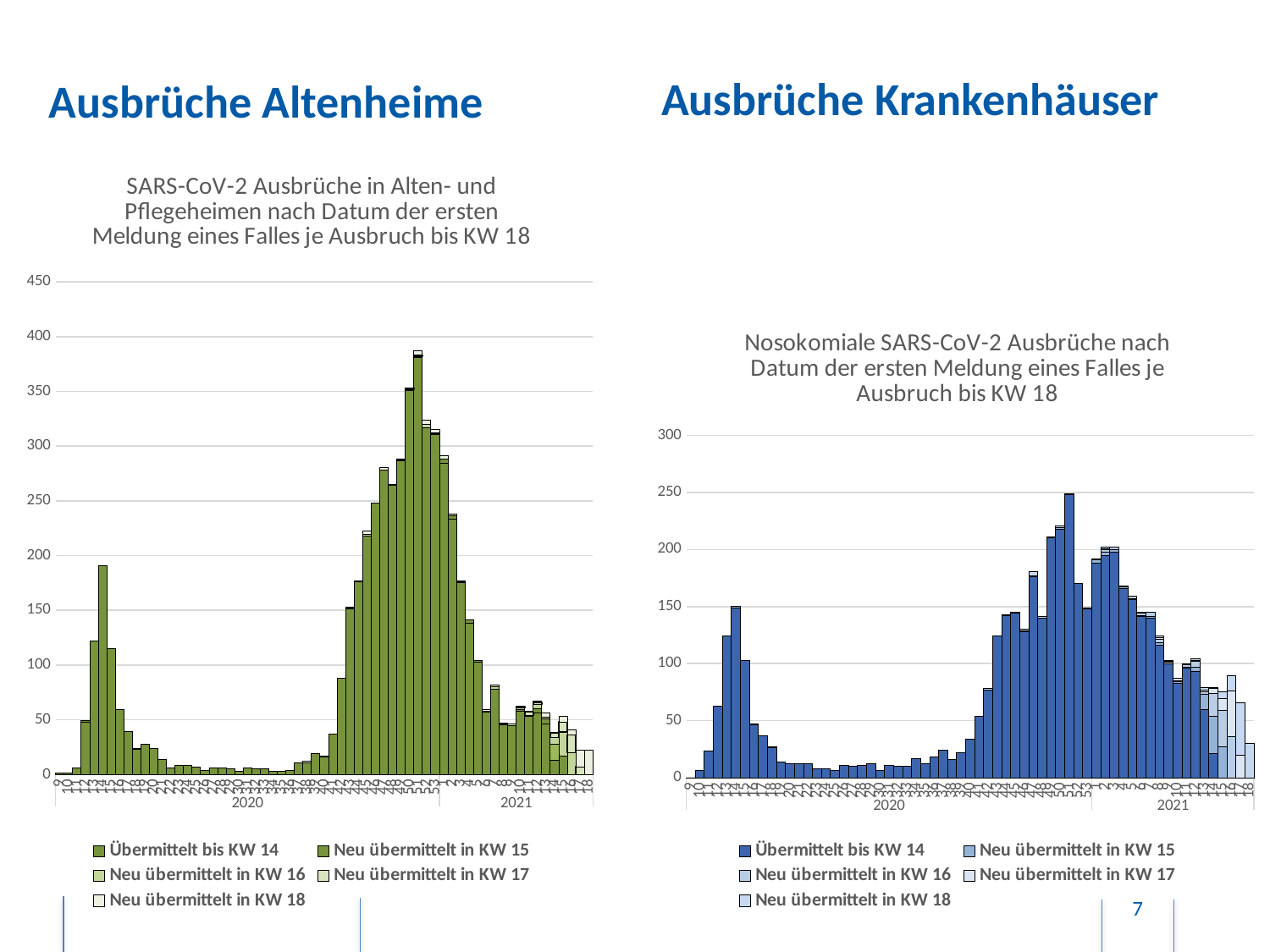
What is the first legend entry of the left chart (Alten- und Pflegeheime)? Übermittelt bis KW 14 In the left chart (Alten- und Pflegeheime), do the values rise or fall from the peak at the end of 2020 into 2021? fall What is the highest value shown on the y-axis of the right chart (Nosokomiale Ausbrüche)? 300 How many series does the legend of the right chart (Nosokomiale Ausbrüche) list? 5 How many series does the legend of the left chart (Alten- und Pflegeheime) list? 5 What kind of chart is the left chart, 'SARS-CoV-2 Ausbrüche in Alten- und Pflegeheimen'? Stacked bar chart What kind of chart is the right chart, 'Nosokomiale SARS-CoV-2 Ausbrüche'? Stacked bar chart In the right chart (Nosokomiale Ausbrüche), is the value of the highest bar greater or less than 200? greater In the right chart (Nosokomiale Ausbrüche), is the spring 2020 peak greater or less than 100? greater Which chart reaches a higher peak value: the left chart (Alten- und Pflegeheime) or the right chart (Nosokomiale Ausbrüche)? The left chart (Alten- und Pflegeheime) In the left chart (Alten- und Pflegeheime), is the value of the highest bar greater or less than 350? greater